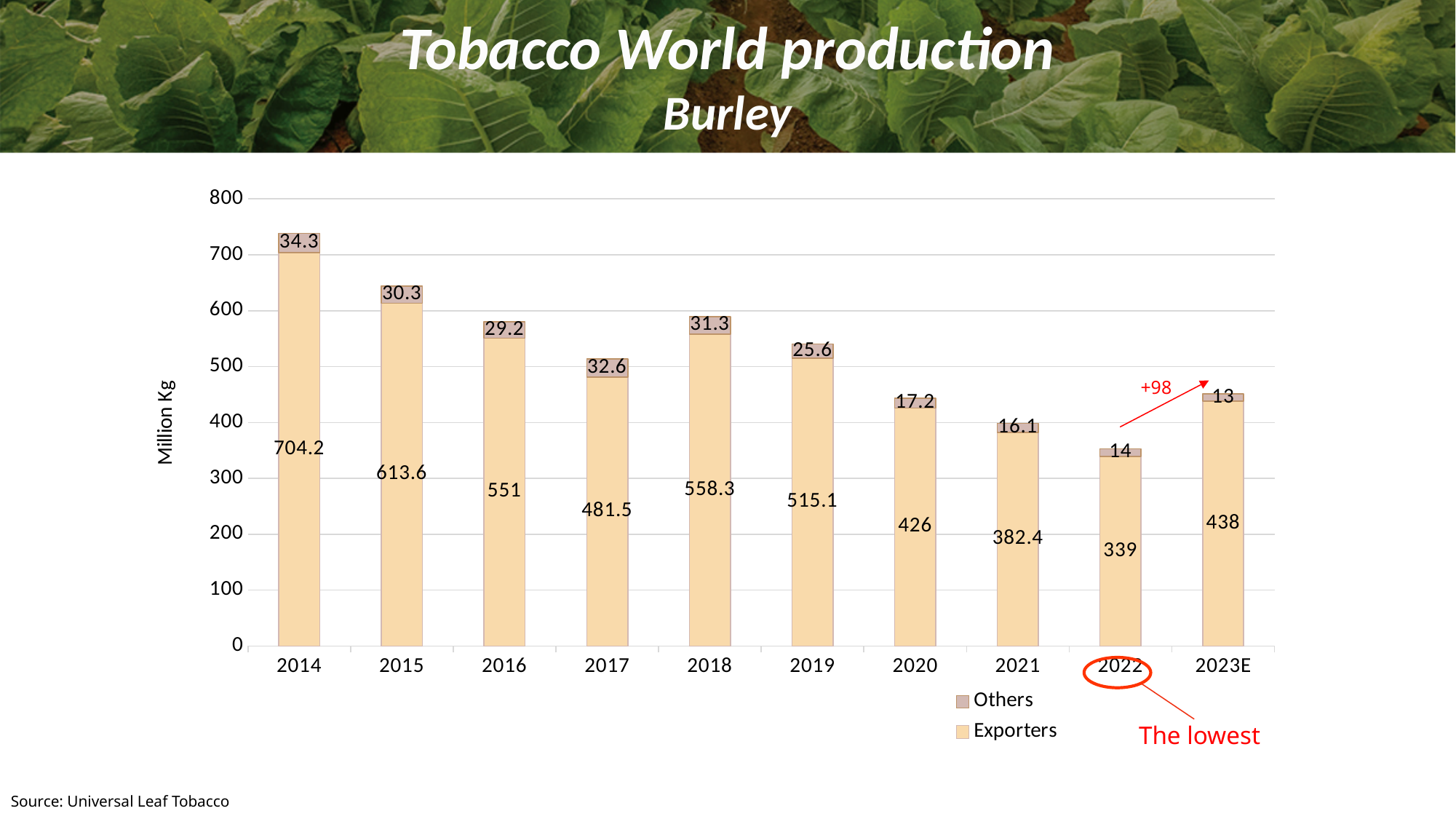
What is the Exporters value for 2014? 704.2 Which year has the lowest Exporters value? 2022 What is the unit shown on the y axis label? Million Kg What is the total of the stacked bar for 2022? 353 How many series does the legend list? 2 How many years are shown on the x axis? 10 What is the Others value for 2019? 25.6 Which is larger, the Exporters value for 2017 or for 2018? 2018 What kind of chart is shown on the slide? Stacked bar chart Which year has the highest Others value? 2014 What is the difference between the Exporters values for 2015 and 2016? 62.6 What is the Exporters value for 2023E? 438